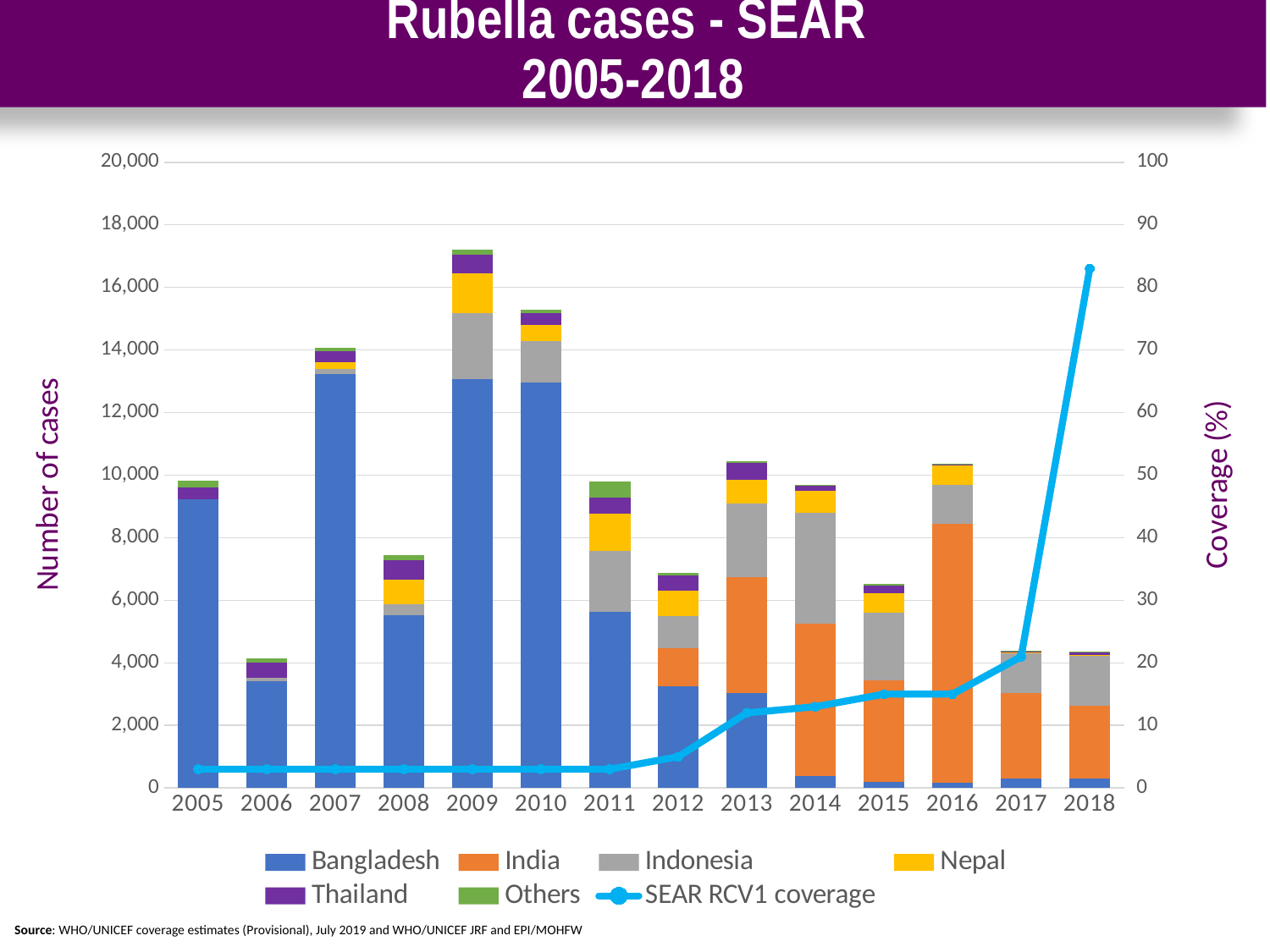
Which year has a larger total number of cases, 2015 or 2016? 2016 Which year has the highest total number of rubella cases? 2009 Does the SEAR RCV1 coverage line rise or fall from 2005 to 2018? rise Is the total number of cases in 2009 greater or less than 16,000? greater What type of chart is shown on the slide? Stacked bar chart with a line How many series does the legend list? 7 How many years are shown along the x axis? 14 Is the SEAR RCV1 coverage in 2018 greater or less than 70? greater Is the total number of cases in 2006 greater or less than 6,000? less What is the title of the right-hand vertical axis? Coverage (%)